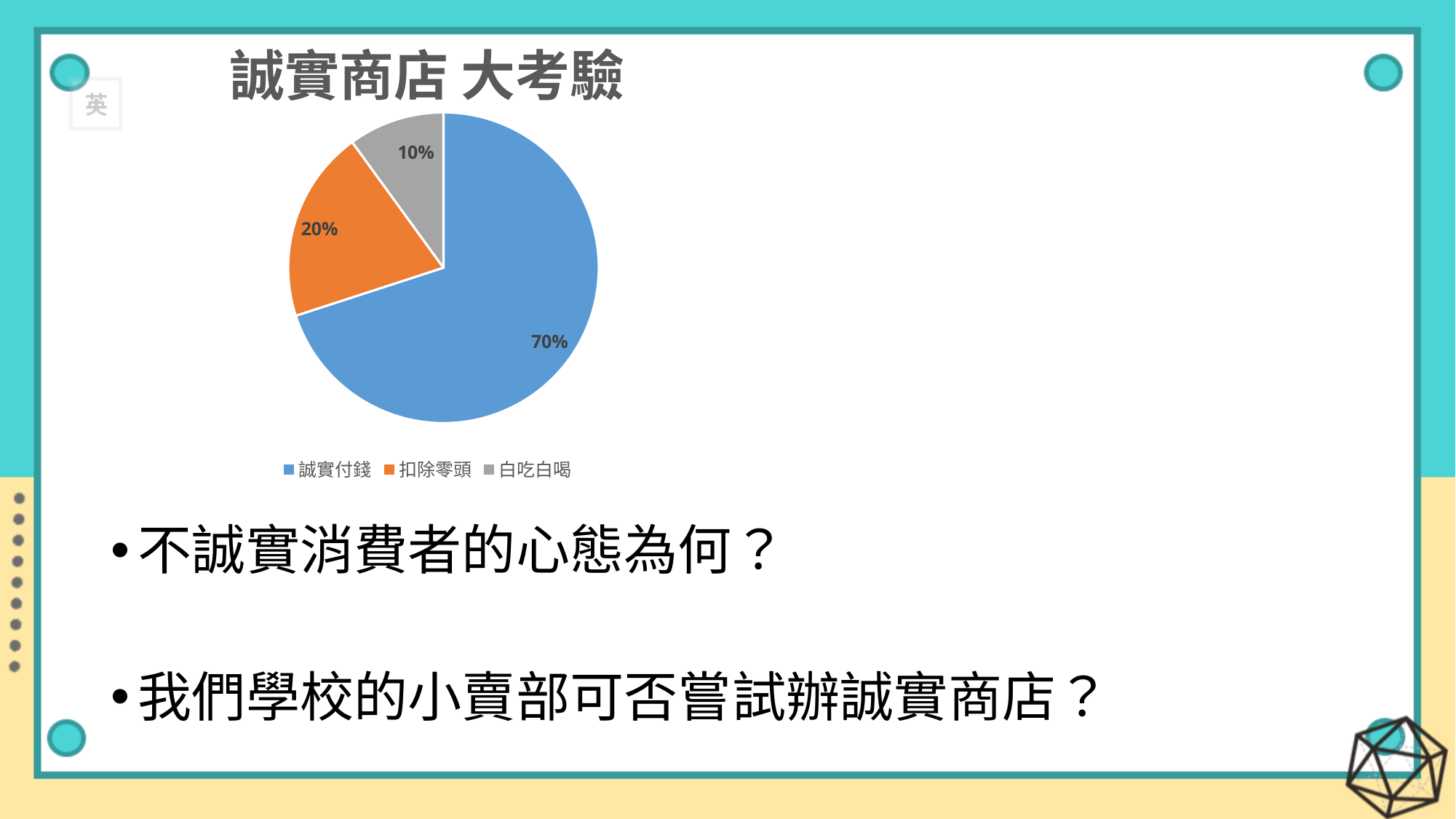
Which is larger, the share for 扣除零頭 or the share for 白吃白喝? 扣除零頭 What colour is the slice for 扣除零頭? orange What percentage of the pie is 誠實付錢? 70% What percentage of the pie is 白吃白喝? 10% Which category has the smallest share of the pie? 白吃白喝 What is the difference in percentage points between 扣除零頭 and 白吃白喝? 10 Which category has the largest share of the pie? 誠實付錢 What is the difference in percentage points between 誠實付錢 and 扣除零頭? 50 What kind of chart is shown on the slide? pie chart What is the title of the chart? 誠實商店 大考驗 How many categories does the pie chart have? 3 What percentage of the pie is 扣除零頭? 20%